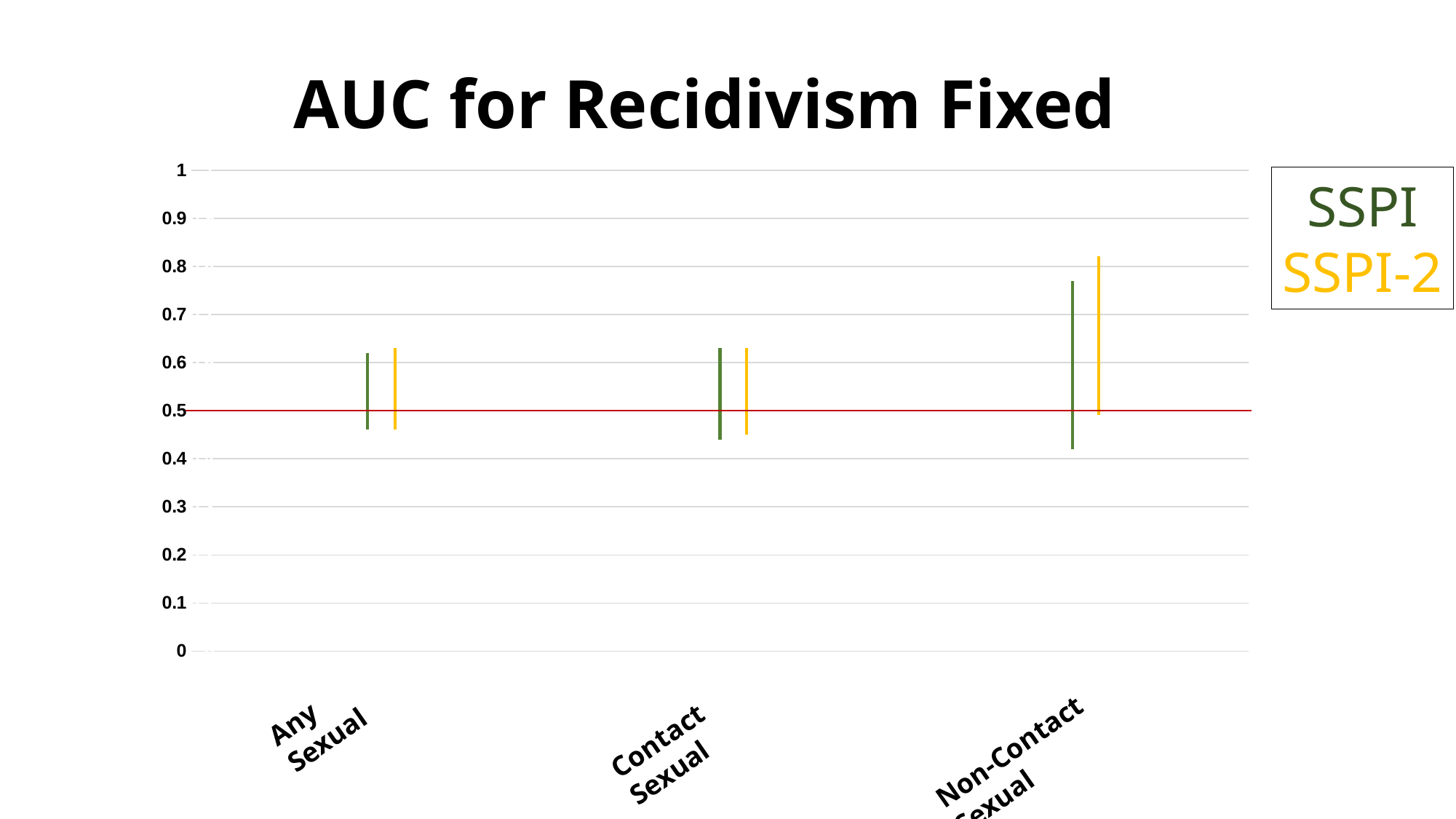
How many categories are shown on the x axis? 3 Which category shows the widest ranges for both series? Non-Contact Sexual How many series does the legend list? 2 Is the lower end of the SSPI range for Non-Contact Sexual greater or less than 0.5? less Is the upper end of the SSPI-2 range for Any Sexual greater or less than 0.5? greater What are the names of the two series in the legend? SSPI and SSPI-2 At what value on the y axis is the red horizontal reference line drawn? 0.5 Which category has the highest upper end of its ranges? Non-Contact Sexual What is the title of the chart? AUC for Recidivism Fixed Is the lower end of the SSPI range for Contact Sexual greater or less than 0.5? less